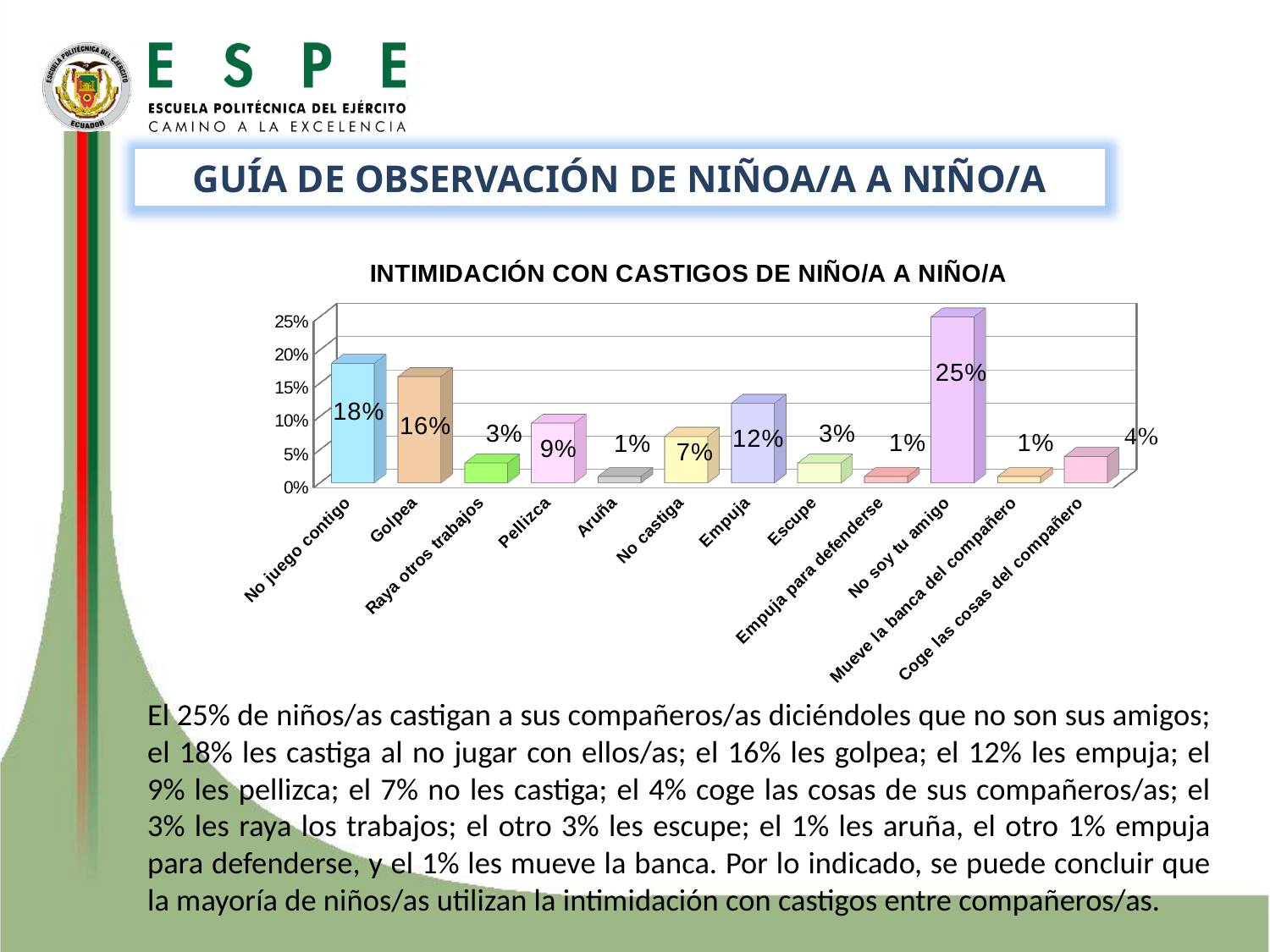
Which is larger, "Raya otros trabajos" or "Pellizca"? Pellizca What is the title of the chart? INTIMIDACIÓN CON CASTIGOS DE NIÑO/A A NIÑO/A What is the difference between "No soy tu amigo" and "Golpea"? 9% What is the value for "Golpea"? 16% Which is larger, "No castiga" or "Empuja"? Empuja Which category has the highest value? No soy tu amigo What is the value for "Coge las cosas del compañero"? 4% What kind of chart is this? Bar chart What is the value for "Pellizca"? 9% What is the difference between "No juego contigo" and "Empuja"? 6% What is the value for "No soy tu amigo"? 25% How many categories are shown on the x axis? 12